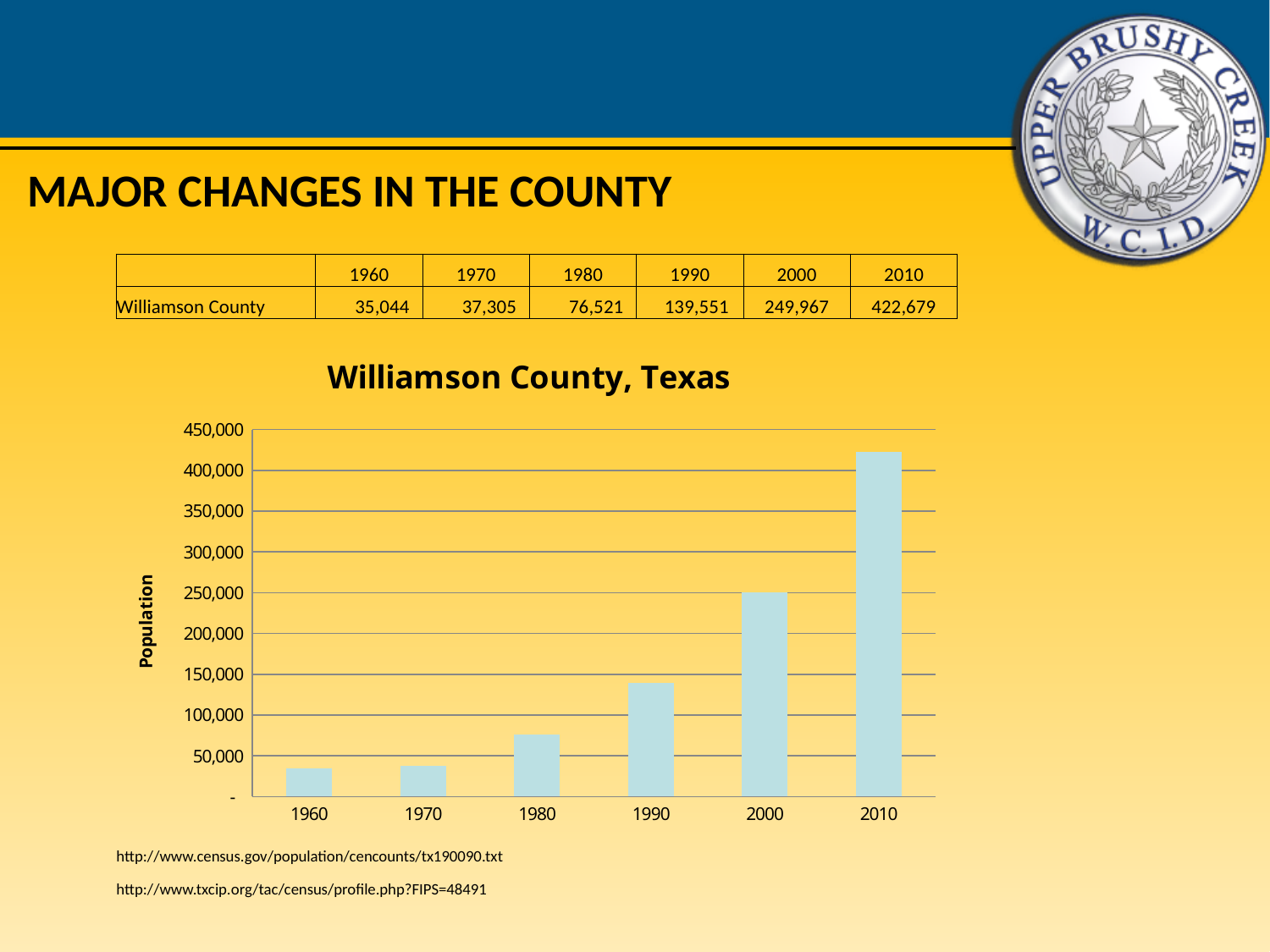
What was the population of Williamson County in 1990? 139,551 Which year has a larger population, 1980 or 1990? 1990 Which year has the highest population in the chart? 2010 What is the label on the vertical axis of the chart? Population What was the population of Williamson County in 1960? 35,044 What was the population of Williamson County in 2010? 422,679 How many years (bars) are plotted in the chart? 6 What is the title of the chart? Williamson County, Texas What is the difference in population between 2010 and 2000? 172,712 What type of chart is shown on the slide? bar chart Which year has the lowest population in the chart? 1960 Does the population rise or fall from 1960 to 2010 along the x axis? rise